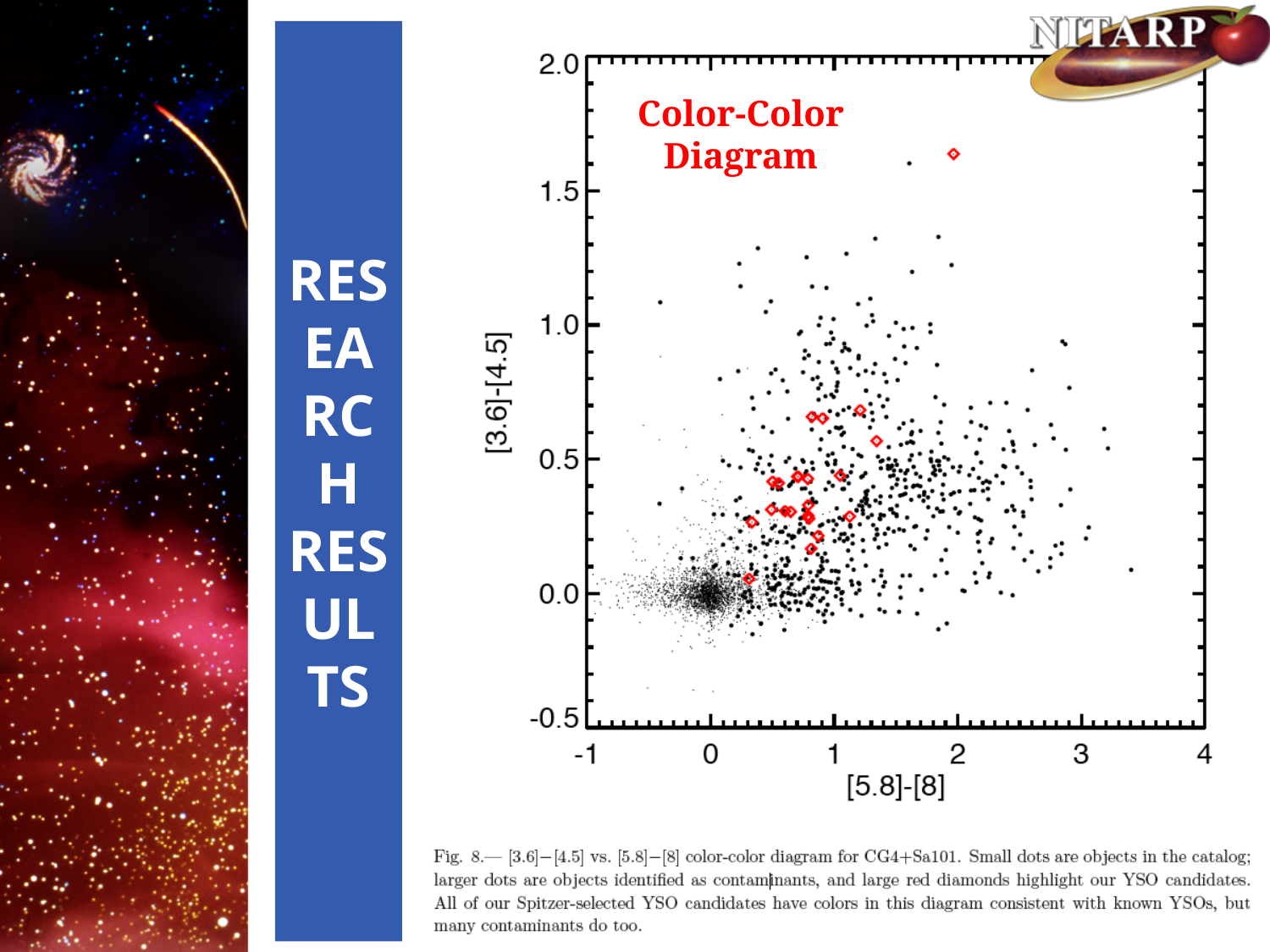
Are all red diamonds except the highest one below or above 1.0 on the [3.6]-[4.5] axis? below What kind of chart is the Color-Color Diagram? scatter plot Is the [5.8]-[8] value of the lowest red diamond greater or less than 1? less Is the [3.6]-[4.5] value of the lowest red diamond greater or less than 0.5? less What is the title printed in red on the chart? Color-Color Diagram According to the caption, what do the large red diamonds on the chart highlight? YSO candidates